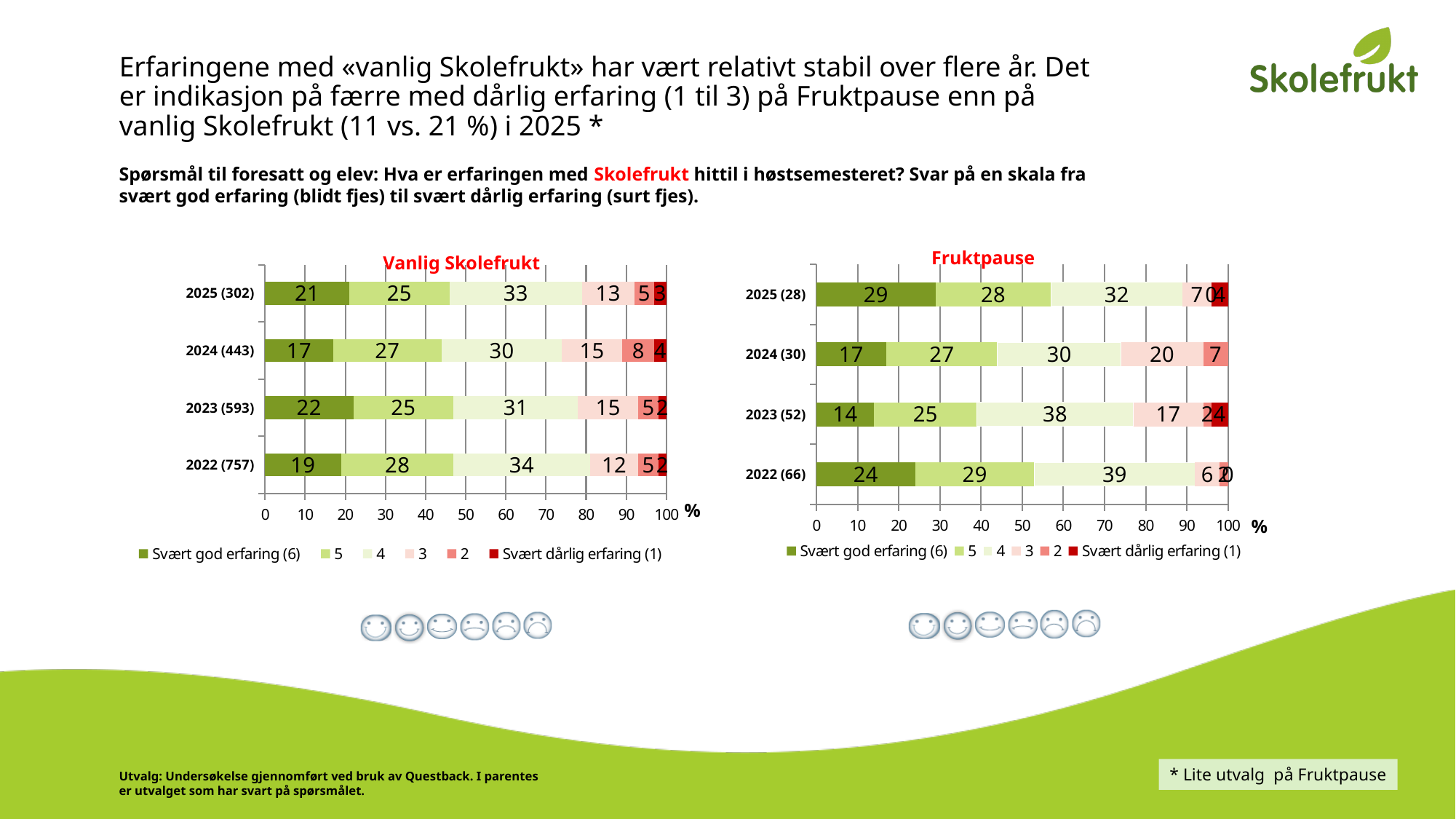
What type of chart is the Vanlig Skolefrukt chart? Stacked bar chart What is the title of the chart on the right side of the slide? Fruktpause In the Fruktpause chart, which is larger: the 'Svært god erfaring (6)' value for 2025 (28) or for 2023 (52)? 2025 (28) In the Fruktpause chart, what is the value for series '3' in 2024 (30)? 20 How many series does the legend of the Fruktpause chart list? 6 In the Vanlig Skolefrukt chart, what is the value for series '4' in 2022 (757)? 34 In the Vanlig Skolefrukt chart, what is the difference between the 'Svært god erfaring (6)' values for 2023 (593) and 2024 (443)? 5 How many year categories does the Vanlig Skolefrukt chart show? 4 In the Fruktpause chart, which year has the highest value for series '4'? 2022 (66) In the Vanlig Skolefrukt chart, what is the value for 'Svært god erfaring (6)' in 2025 (302)? 21 In the Vanlig Skolefrukt chart, which year has the lowest value for 'Svært god erfaring (6)'? 2024 (443) In the Fruktpause chart, what is the value for 'Svært god erfaring (6)' in 2025 (28)? 29